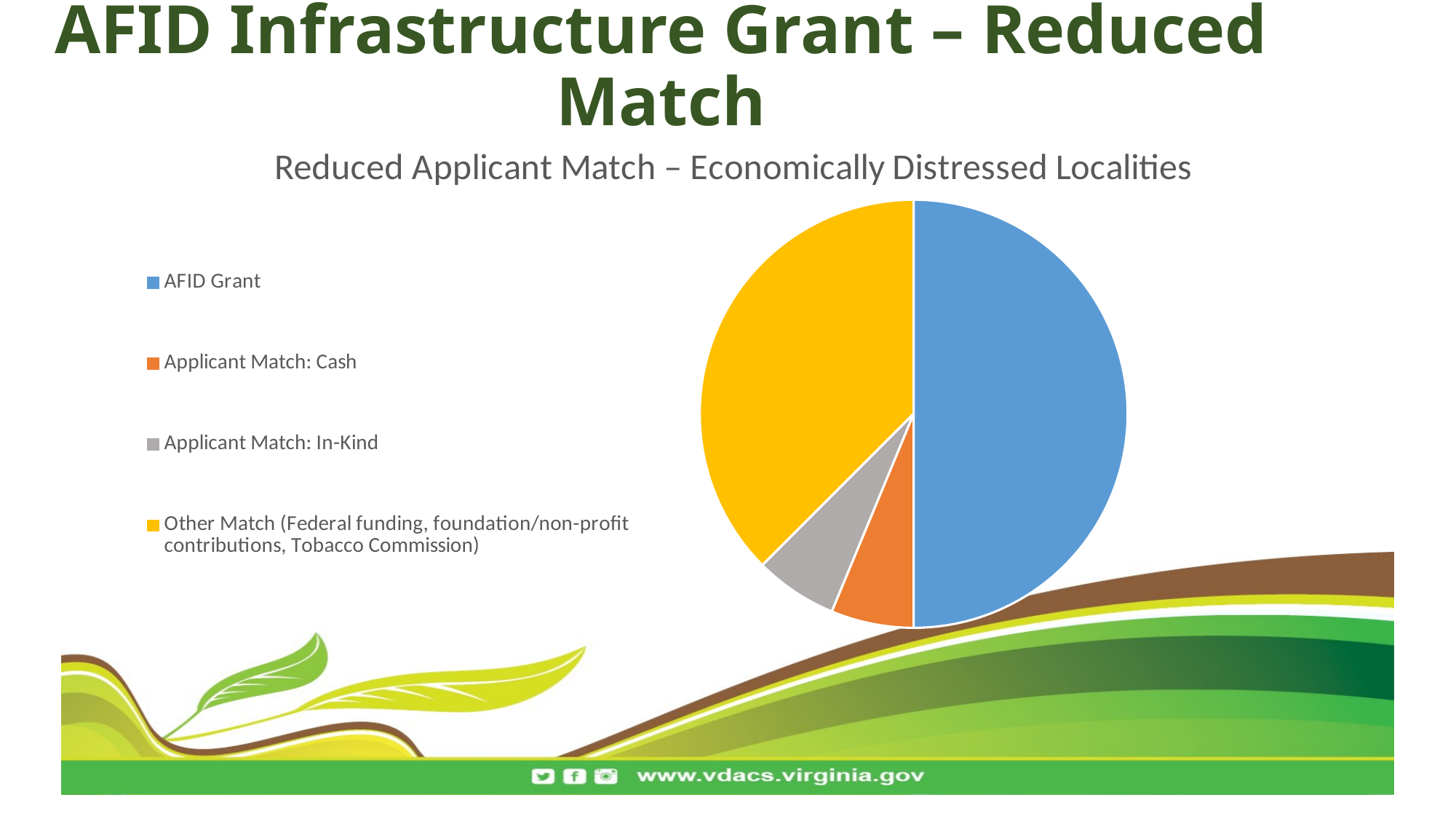
Which is larger, the slice for AFID Grant or the slice for Other Match (Federal funding, foundation/non-profit contributions, Tobacco Commission)? AFID Grant Which is larger, the slice for Other Match (Federal funding, foundation/non-profit contributions, Tobacco Commission) or the slice for Applicant Match: In-Kind? Other Match (Federal funding, foundation/non-profit contributions, Tobacco Commission) How many entries does the chart legend list? 4 Which is larger, the slice for Applicant Match: Cash or the slice for AFID Grant? AFID Grant What kind of chart is shown on the slide? Pie chart Which category has the largest slice of the pie? AFID Grant Which colour represents AFID Grant in the pie chart? Blue How many slices does the pie chart have? 4 What is the title of the chart? Reduced Applicant Match – Economically Distressed Localities